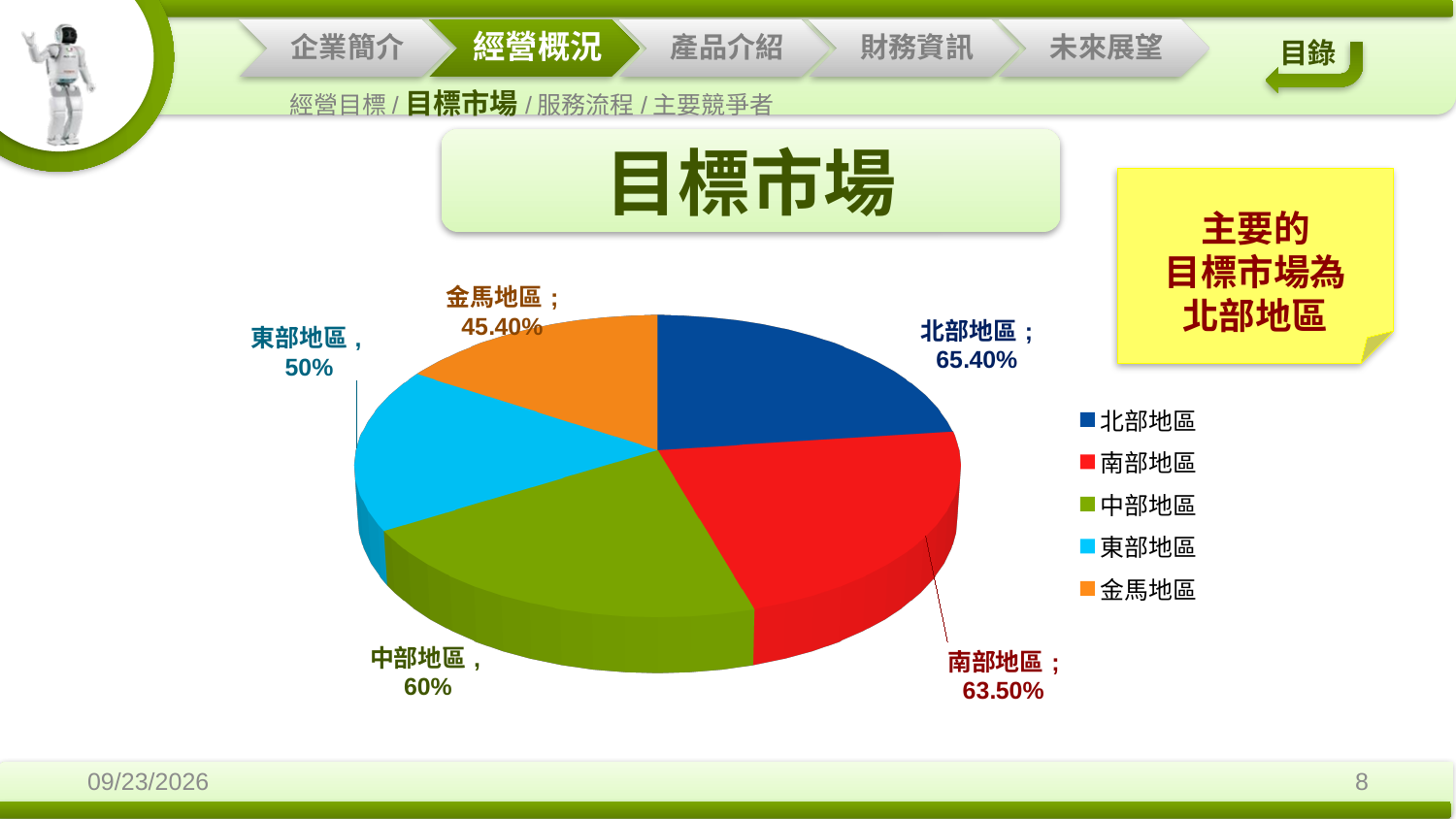
What value is shown for 中部地區 in the pie chart? 60% Which is larger, the value for 東部地區 or the value for 金馬地區? 東部地區 How many slices does the pie chart have? 5 What value is shown for 北部地區 in the pie chart? 65.40% Which region has the highest value in the pie chart? 北部地區 What value is shown for 南部地區 in the pie chart? 63.50% Which region has the lowest value in the pie chart? 金馬地區 What kind of chart is shown on the slide? Pie chart What value is shown for 金馬地區 in the pie chart? 45.40% What is the difference between the values for 中部地區 and 東部地區? 10% What is the title of the chart on the slide? 目標市場 What value is shown for 東部地區 in the pie chart? 50%